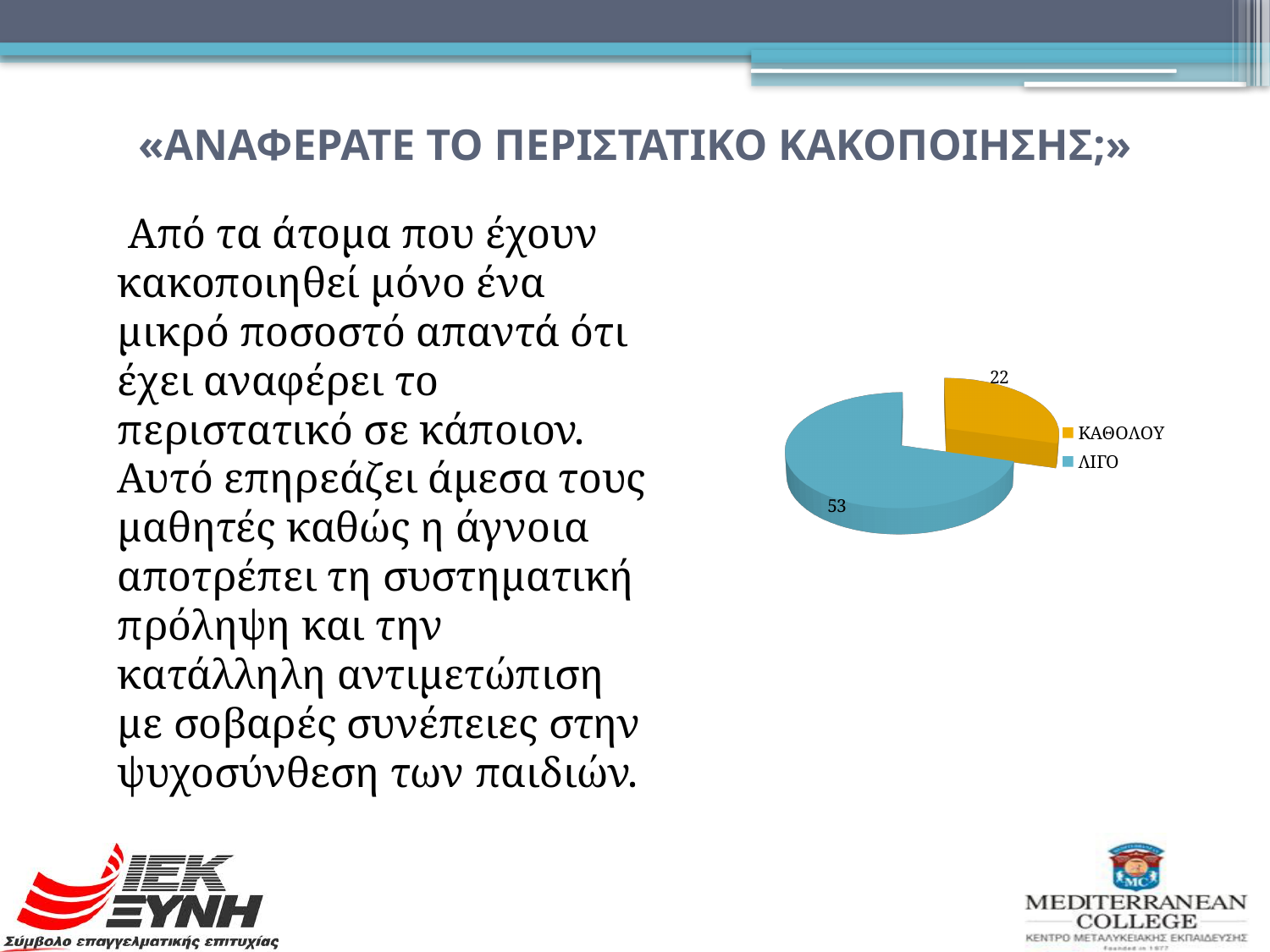
What is the total of the two values shown in the pie chart? 75 What are the two legend entries of the pie chart? ΚΑΘΟΛΟΥ and ΛΙΓΟ How many categories does the pie chart show? 2 Which is larger, the value for ΚΑΘΟΛΟΥ or the value for ΛΙΓΟ? ΛΙΓΟ What is the value for ΛΙΓΟ in the pie chart? 53 Which category has the smallest slice in the pie chart? ΚΑΘΟΛΟΥ Which category has the largest slice in the pie chart? ΛΙΓΟ What colour is the ΚΑΘΟΛΟΥ slice in the pie chart? orange What kind of chart is shown on the slide? pie chart What is the value for ΚΑΘΟΛΟΥ in the pie chart? 22 What is the difference between the values for ΛΙΓΟ and ΚΑΘΟΛΟΥ? 31